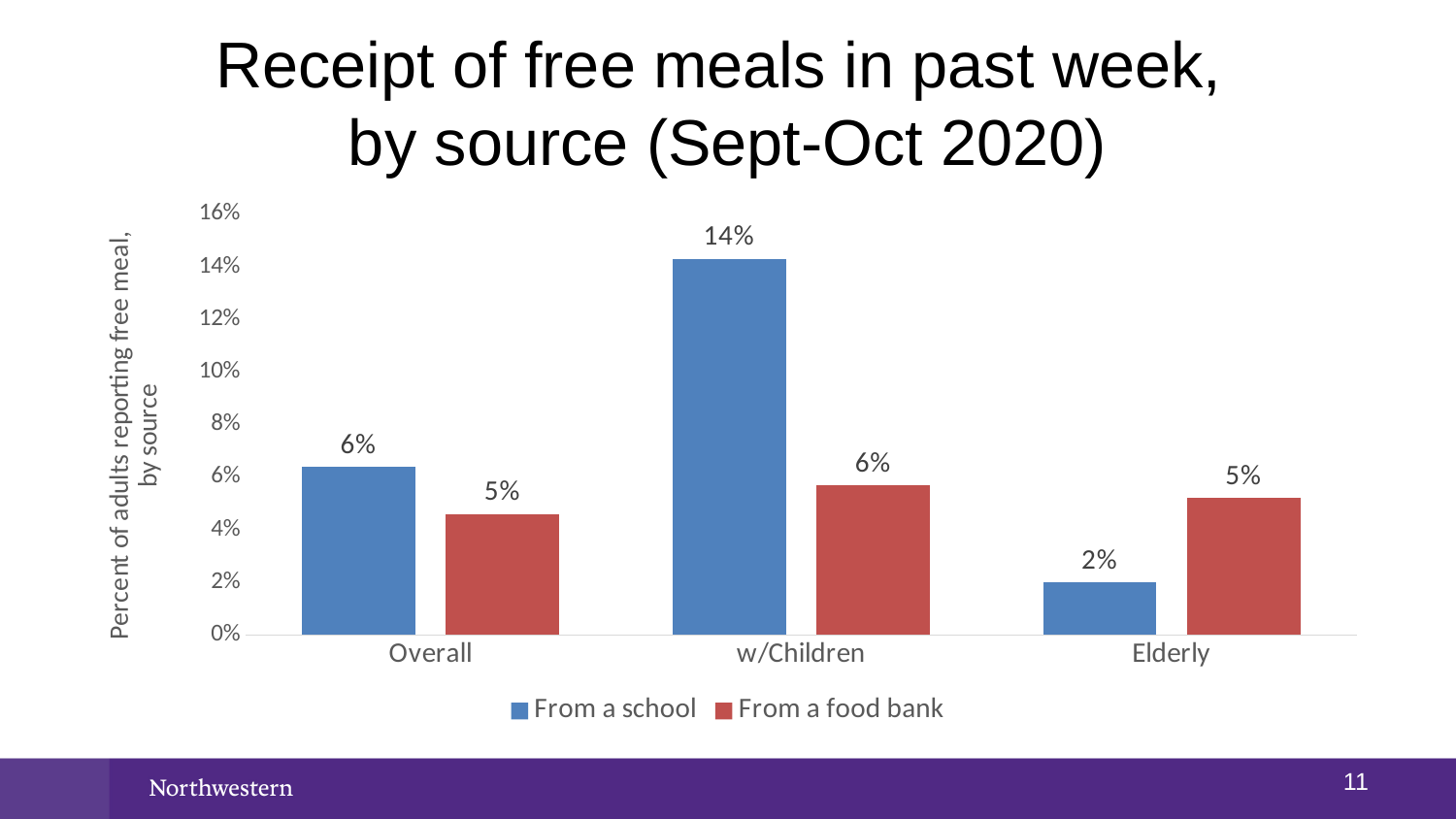
What percentage of adults with children reported a free meal from a school? 14% Which category has the lowest value for 'From a school'? Elderly What is the value for Elderly in the 'From a school' series? 2% Which category has the highest value for 'From a school'? w/Children For the w/Children group, what is the difference between the 'From a school' and 'From a food bank' values? 8% How many categories are shown on the x axis? 3 What is the value for Overall in the 'From a school' series? 6% For the Elderly group, which is larger: 'From a school' or 'From a food bank'? From a food bank What kind of chart is shown on the slide? Bar chart How many series does the legend list? 2 Is the 'From a school' value for w/Children greater or less than 10%? greater What is the value for Elderly in the 'From a food bank' series? 5%